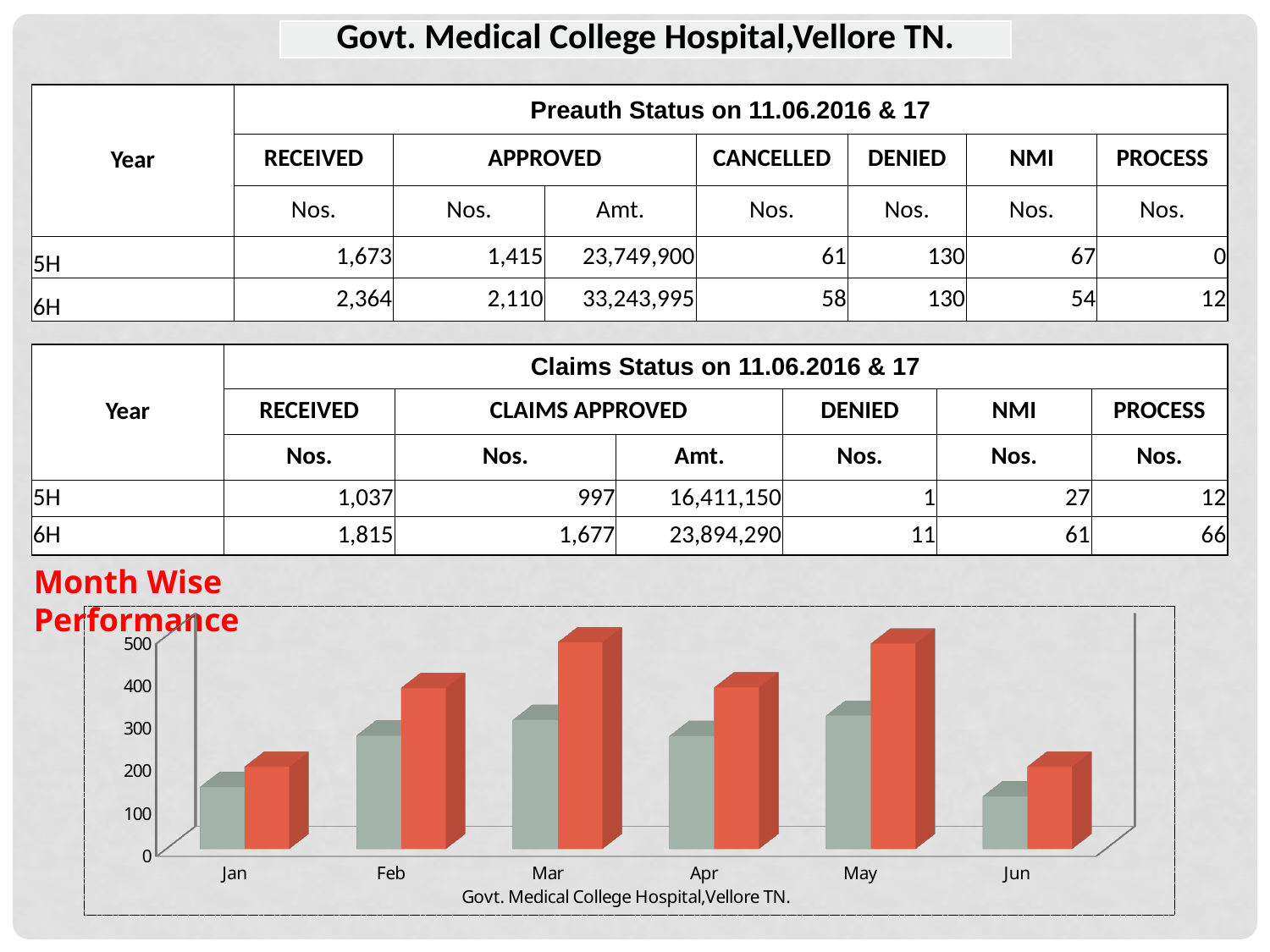
In the bar chart, is the value of the grey bar for Jan greater or less than 200? less In the bar chart, which is larger for Mar: the grey bar or the red bar? the red bar What kind of chart is shown under the heading 'Month Wise Performance'? bar chart In the bar chart, is the value of the grey bar for Jun greater or less than 200? less How many bars are plotted for each month in the bar chart? 2 How many months are shown on the x axis of the bar chart? 6 What title is printed below the x axis of the bar chart? Govt. Medical College Hospital,Vellore TN. In the bar chart, is the value of the red bar for Mar greater or less than 400? greater In the bar chart, which is larger: the red bar for Feb or the red bar for Jan? Feb In the bar chart, do the red bars rise or fall from Jan to Mar? rise